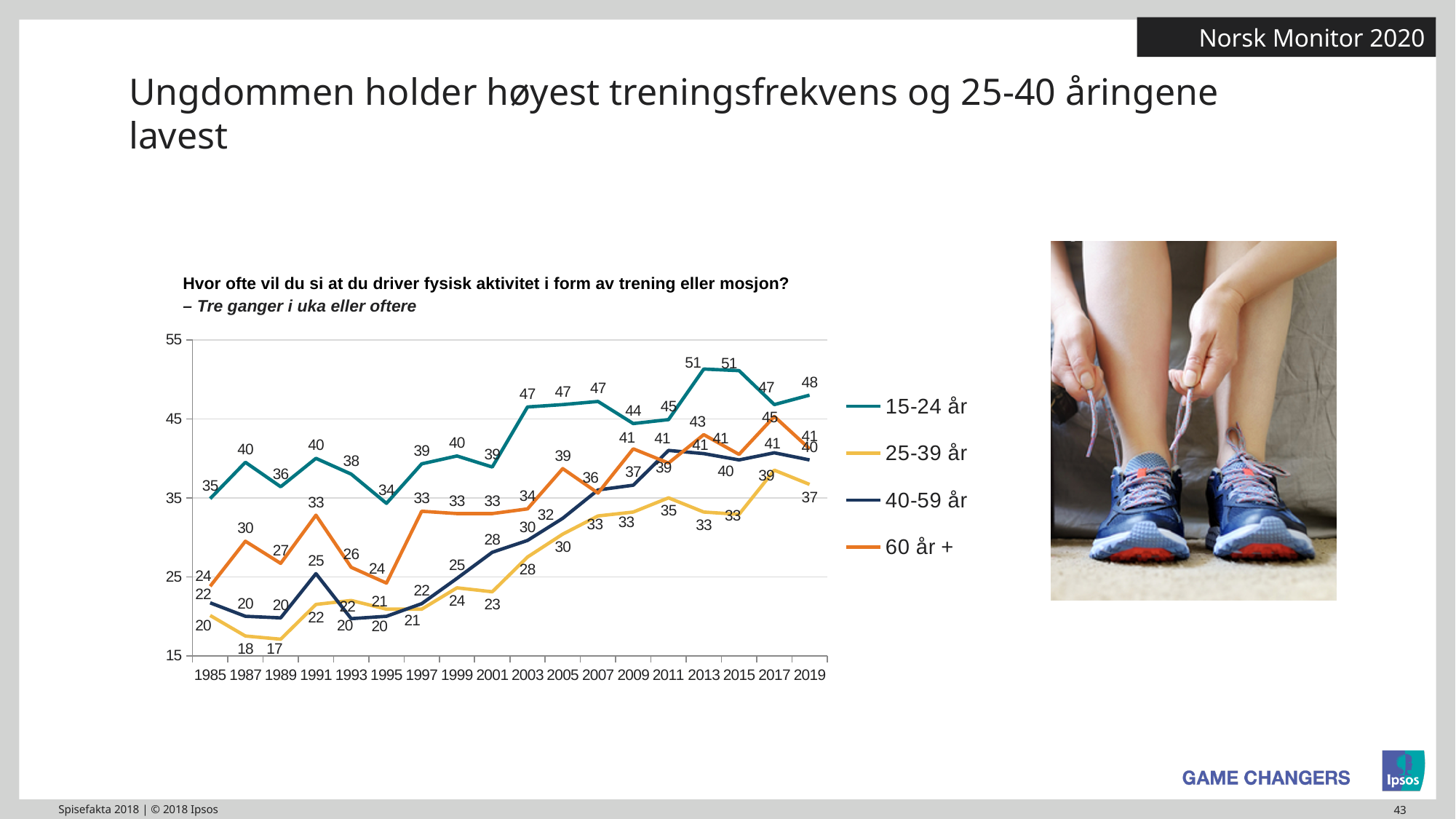
What is the value for the 15-24 år series in 2019? 48 What is the difference between the 15-24 år value and the 25-39 år value in 2019? 11 What is the highest value reached by the 15-24 år series? 51 Which series is shown in orange in the legend? 60 år + In which year does the 25-39 år series reach its lowest value? 1989 What is the value for the 60 år + series in 2017? 45 How many years are shown on the x axis? 18 What kind of chart is shown on the slide? Line chart How many series does the legend list? 4 Does the 40-59 år series rise or fall overall from 1985 to 2019? Rise What is the value for the 25-39 år series in 1989? 17 In 2013, which series has the larger value: 60 år + or 40-59 år? 60 år +